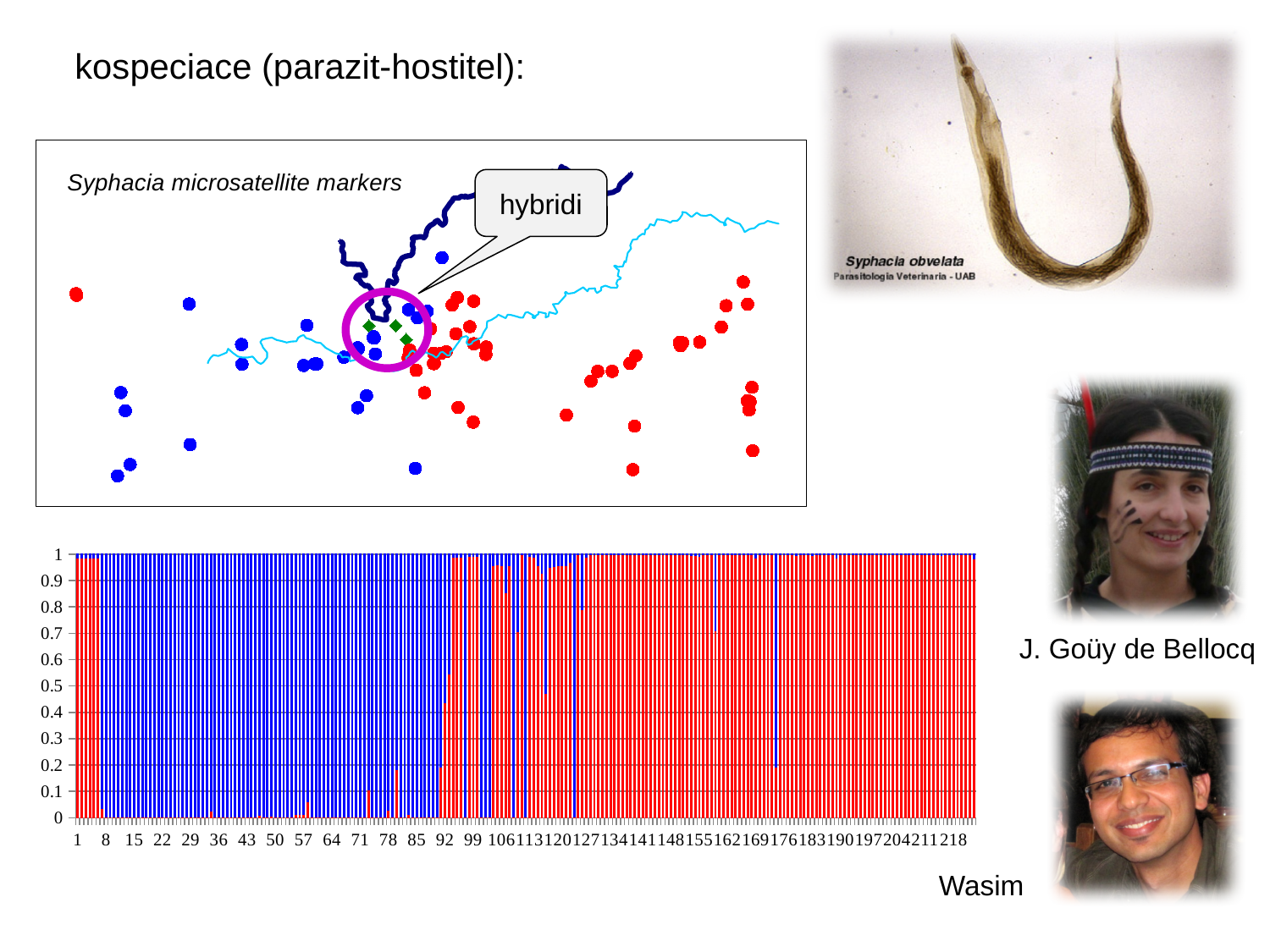
In the bottom bar chart, is the red portion of the bar at x = 50 greater or less than 0.5? less In the bottom bar chart, what is the last label on the x axis? 218 In the bottom bar chart, what is the first label on the x axis? 1 In the bottom bar chart, what is the highest value shown on the y axis? 1 In the bottom bar chart, how many different colours are used for the bar segments? 2 In the bottom bar chart, which colour dominates the bars between x = 15 and x = 85, blue or red? blue In the bottom bar chart, what is the lowest value shown on the y axis? 0 In the bottom bar chart, which colour dominates the bars between x = 134 and x = 218, blue or red? red What kind of chart is shown at the bottom left of the slide? bar chart In the bottom bar chart, is the blue portion of the bar at x = 50 greater or less than 0.5? greater In the bottom bar chart, what is the y-axis tick spacing between labelled values? 0.1 In the bottom bar chart, is the red portion of the bar at x = 190 greater or less than 0.5? greater